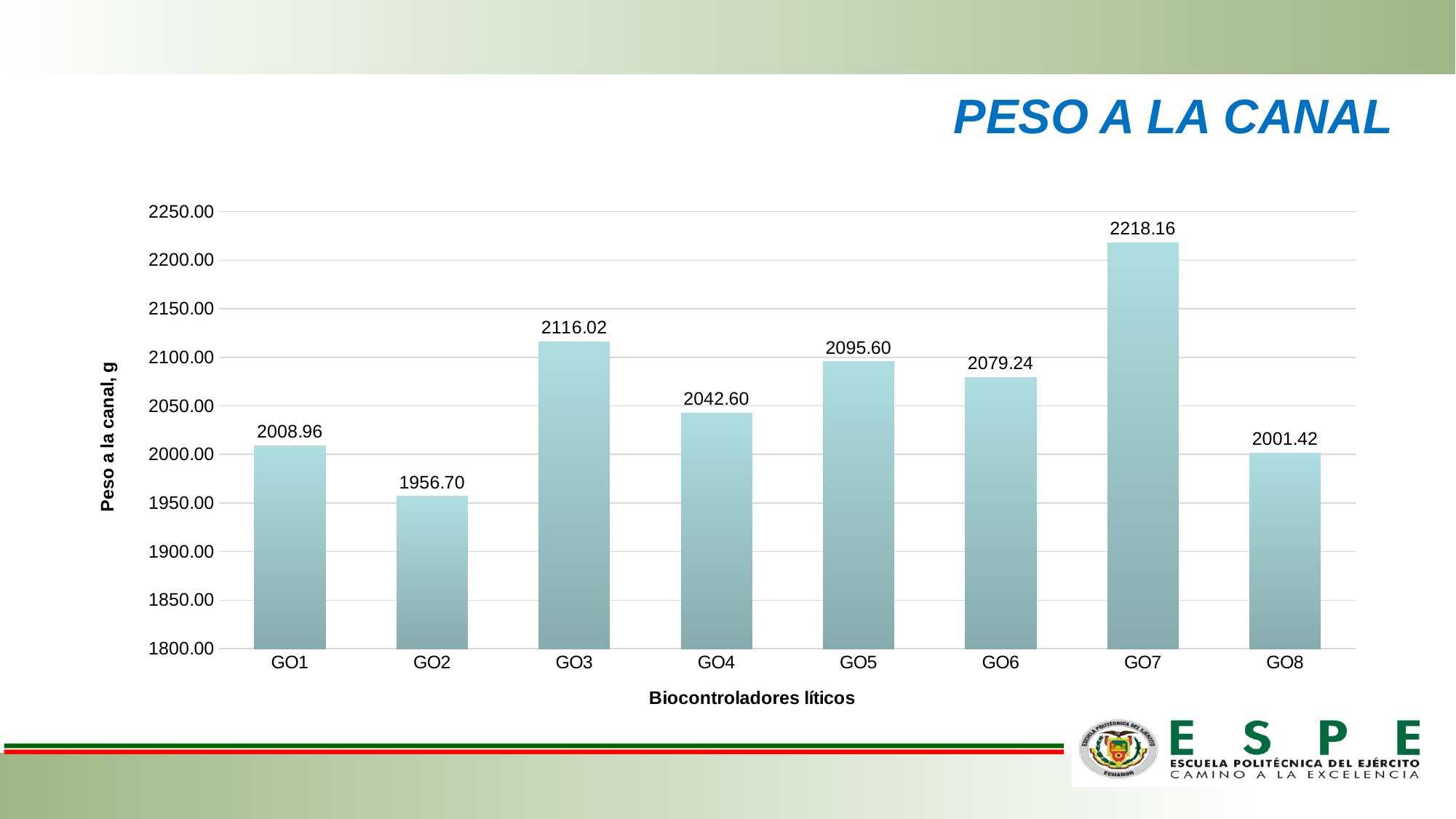
What is the difference between the values for GO7 and GO2? 261.46 What kind of chart is shown on the slide? bar chart What is the value for GO3? 2116.02 Is the value for GO2 greater or less than 2000.00? less Which is larger, the value for GO6 or the value for GO4? GO6 How many categories are shown on the x axis? 8 What is the label of the y axis? Peso a la canal, g Which category has the highest value? GO7 What is the value for GO8? 2001.42 Which category has the lowest value? GO2 What is the difference between the values for GO3 and GO4? 73.42 What is the value for GO5? 2095.60